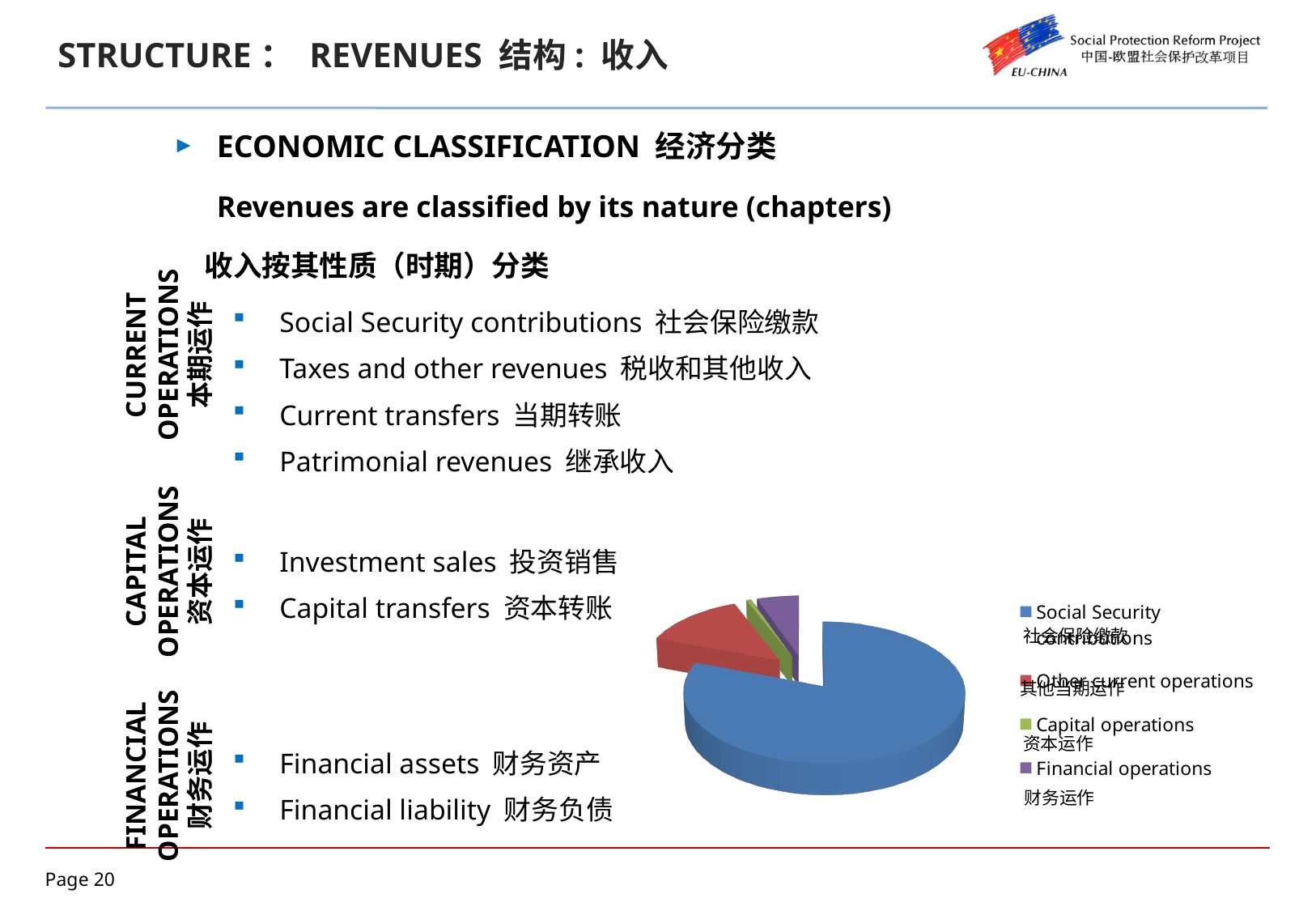
Which colour represents Social Security contributions in the pie chart? blue How many slices does the pie chart have? 4 Does the Social Security contributions slice make up more or less than half of the pie? more Which is larger in the pie chart, Social Security contributions or Financial operations? Social Security contributions How many entries does the pie chart's legend list? 4 Which colour represents Capital operations in the pie chart? green Which is larger in the pie chart, Social Security contributions or Other current operations? Social Security contributions What kind of chart is shown on the slide? pie chart Which category has the largest slice of the pie chart? Social Security contributions Which is larger in the pie chart, Other current operations or Capital operations? Other current operations